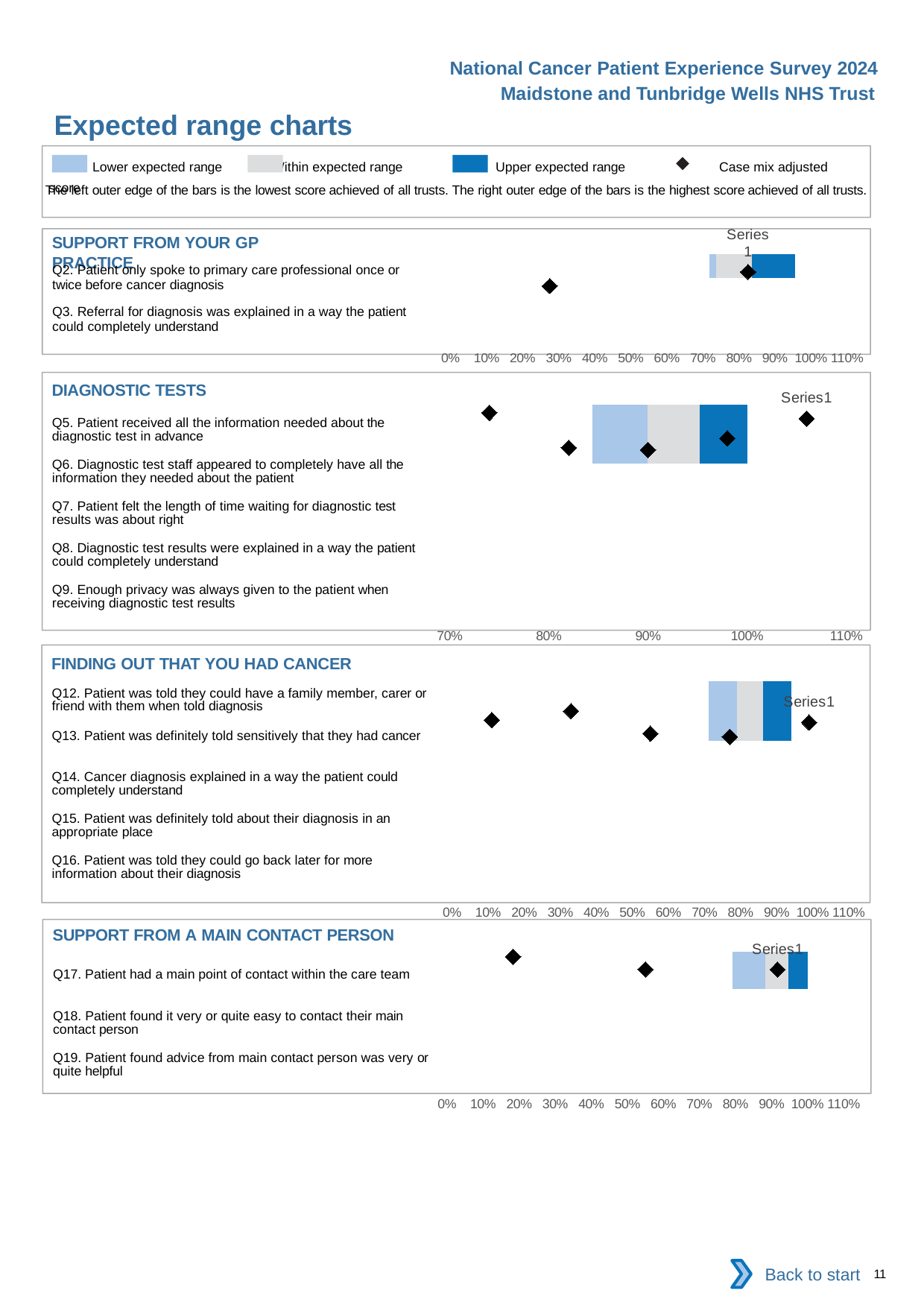
How many questions are listed in the 'Diagnostic tests' chart? 5 In the 'Support from a main contact person' chart, what is the highest value shown on the x axis? 110% In the 'Diagnostic tests' chart, what is the lowest value shown on the x axis? 70% How many entries does the shared legend at the top of the slide list? 4 In the legend, which colour represents the upper expected range? Dark blue How many questions are listed in the 'Support from your GP practice' chart? 2 How many questions are listed in the 'Support from a main contact person' chart? 3